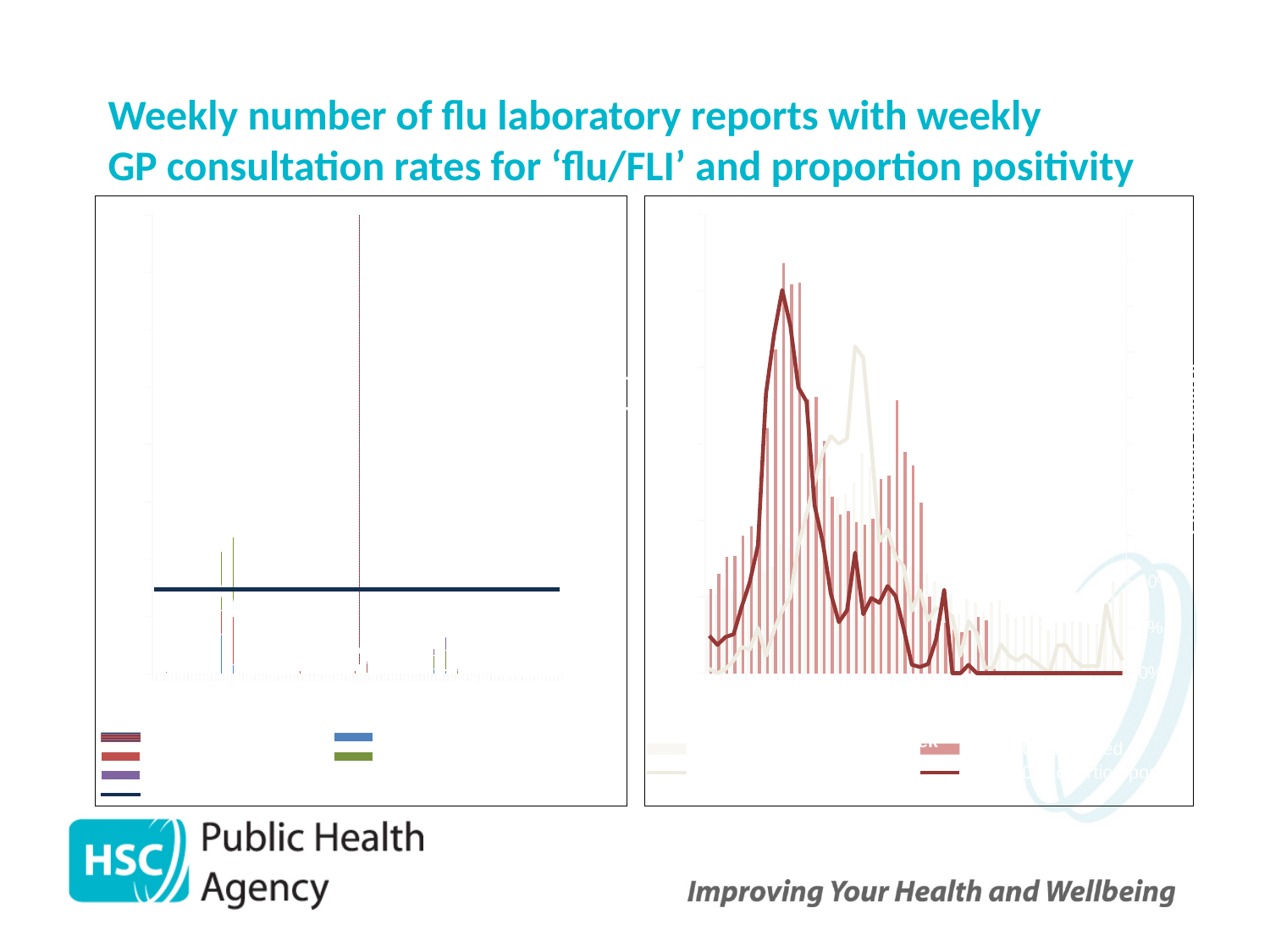
In the right chart, which line reaches its peak earlier along the x axis, the dark red line or the cream line? The dark red line What is the title shown above the charts on the slide? Weekly number of flu laboratory reports with weekly GP consultation rates for 'flu/FLI' and proportion positivity In the right chart, does the dark red line end higher or lower than where it starts? Lower What kind of chart is the chart on the left of the slide? Bar chart with a line overlay In the left chart, does the dark blue line rise, fall, or stay flat along the x axis? Stays flat What kind of chart is the chart on the right of the slide? Bar chart with line overlays In the right chart, does the dark red line rise steadily, fall steadily, or rise to a peak and then fall along the x axis? Rises to a peak and then falls In the right chart, which line reaches a higher peak, the dark red line or the cream line? The dark red line How many charts are shown on the slide? 2